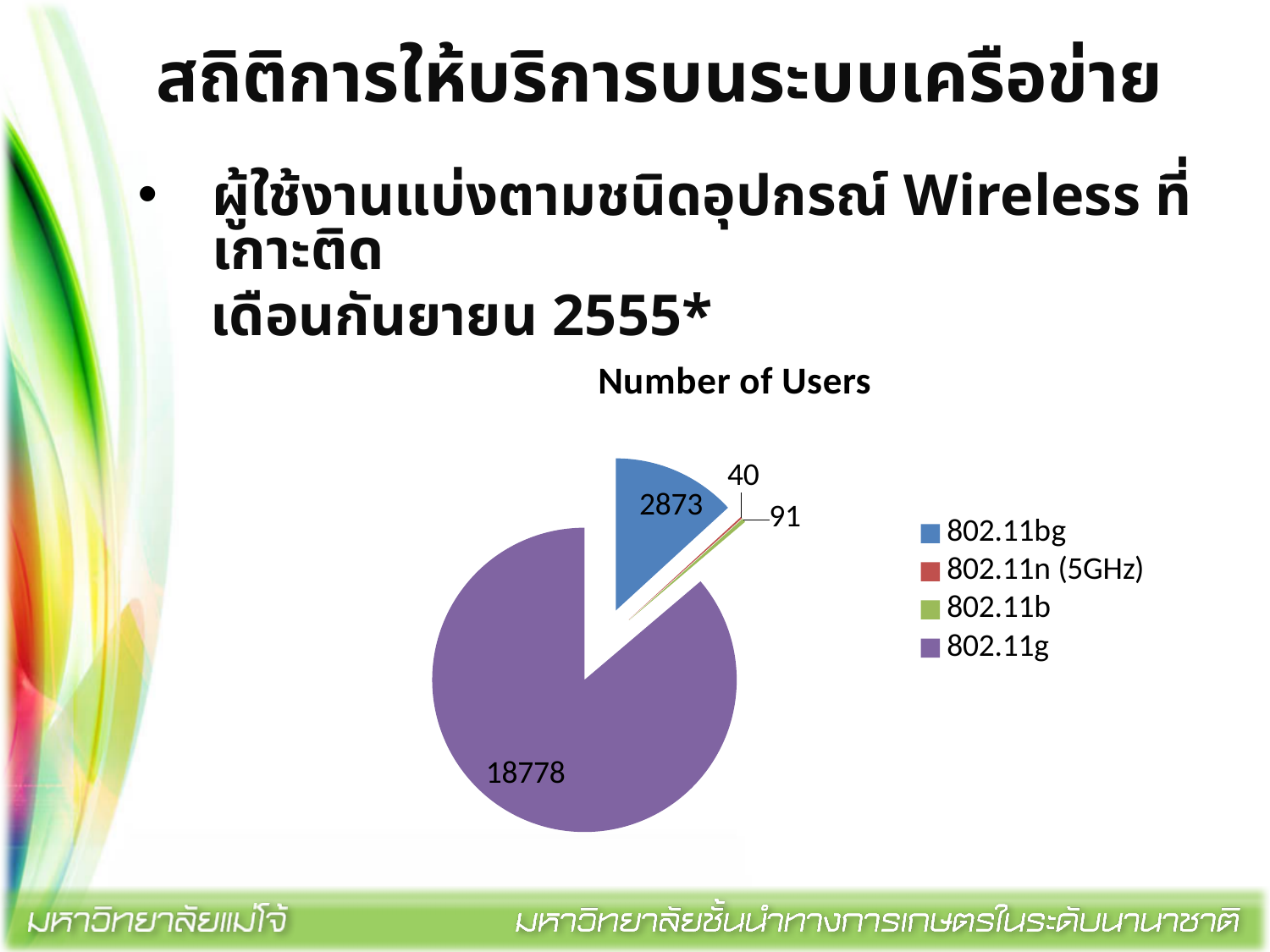
What colour represents 802.11g in the pie chart? purple How many categories does the legend of the pie chart list? 4 Which category has the largest number of users? 802.11g What type of chart is shown on the slide? pie chart What is the number of users for 802.11g? 18778 Which category has the smallest number of users? 802.11n (5GHz) What is the difference in number of users between 802.11g and 802.11bg? 15905 What is the number of users for 802.11b? 91 Which has more users, 802.11b or 802.11n (5GHz)? 802.11b What is the number of users for 802.11bg? 2873 What is the title of the chart? Number of Users What is the number of users for 802.11n (5GHz)? 40